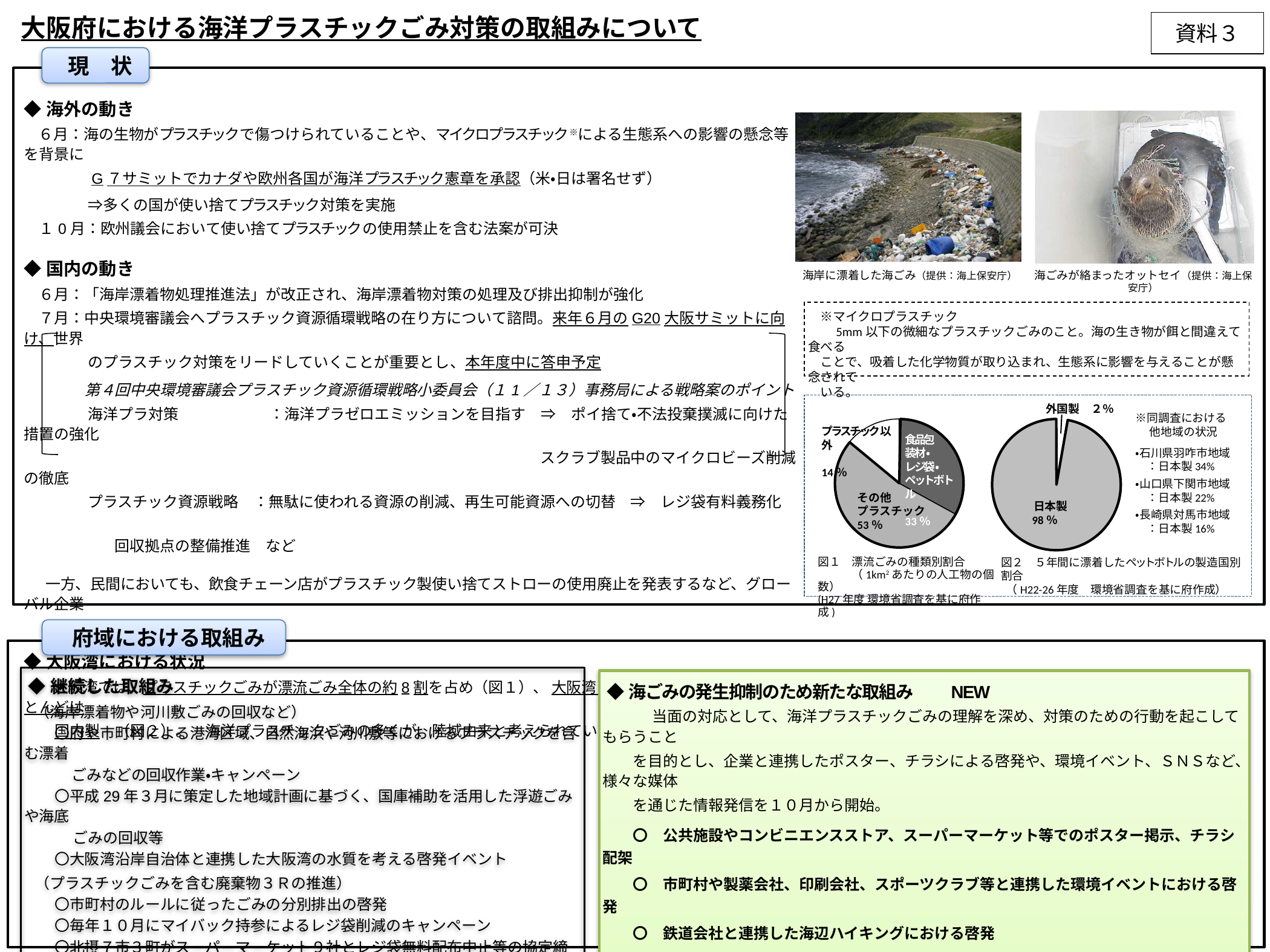
In the chart 図2 5年間に漂着したペットボトルの製造国別割合, which is larger, 日本製 or 外国製? 日本製 In the chart 図2 5年間に漂着したペットボトルの製造国別割合, what share is 外国製? 2% In the chart 図2 5年間に漂着したペットボトルの製造国別割合, what share is 日本製? 98% In the chart 図1 漂流ごみの種類別割合, how many slices does the pie have? 3 What kind of chart is 図1 漂流ごみの種類別割合? Pie chart In the chart 図1 漂流ごみの種類別割合, what share is プラスチック以外? 14% In the chart 図1 漂流ごみの種類別割合, what is the difference in percentage points between その他プラスチック and 食品包装材・レジ袋・ペットボトル? 20 In the chart 図1 漂流ごみの種類別割合, which category has the smallest share? プラスチック以外 In the chart 図1 漂流ごみの種類別割合, which category has the largest share? その他プラスチック In the chart 図1 漂流ごみの種類別割合, what share is その他プラスチック? 53% In the chart 図2 5年間に漂着したペットボトルの製造国別割合, how many slices does the pie have? 2 In the chart 図1 漂流ごみの種類別割合, what share is 食品包装材・レジ袋・ペットボトル? 33%